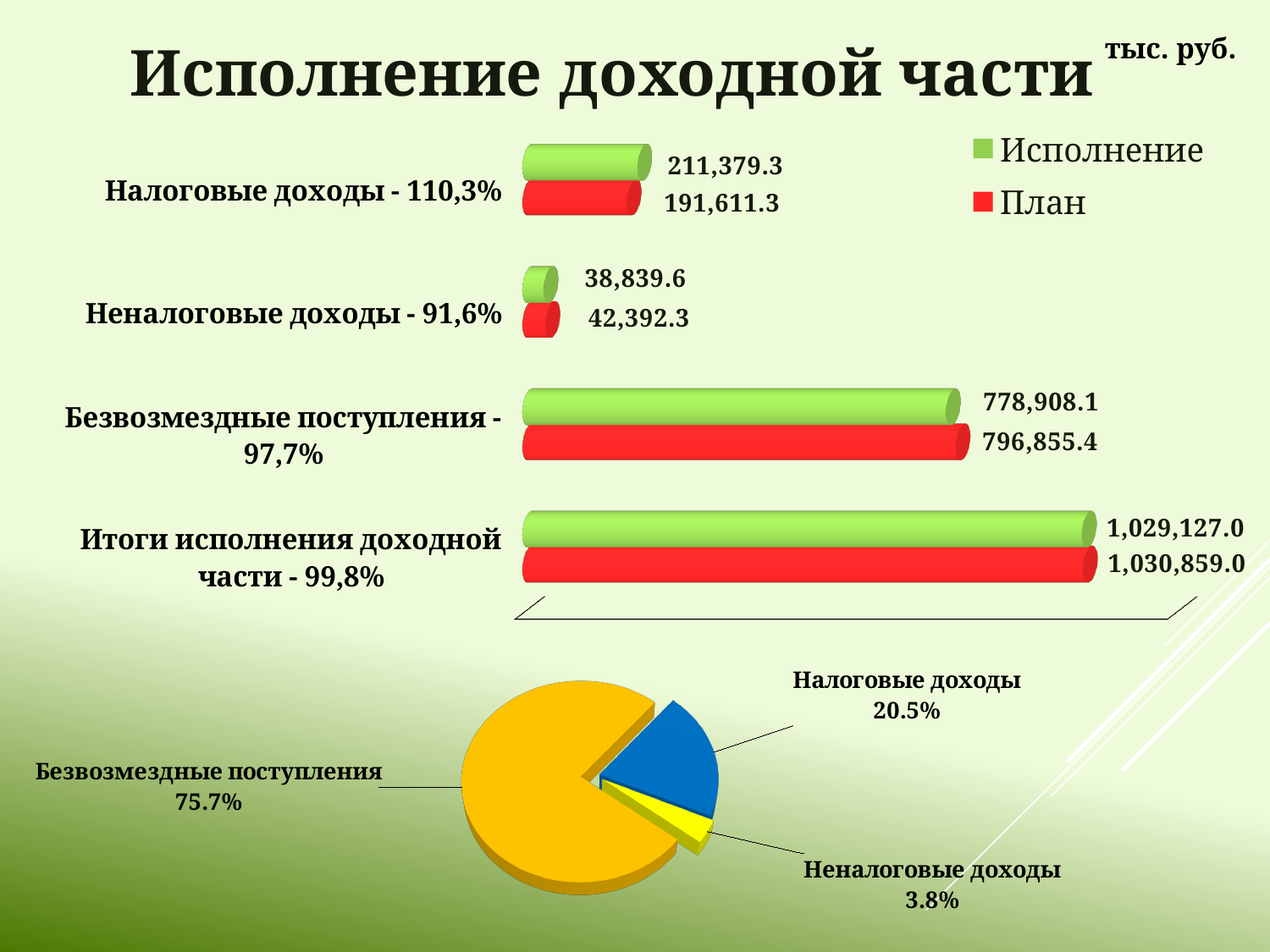
In the bar chart, which is larger for Безвозмездные поступления: Исполнение or План? План In the pie chart, which slice is the smallest? Неналоговые доходы In the bar chart, what is the План value for Безвозмездные поступления? 796,855.4 In the bar chart, which category has the lowest Исполнение value? Неналоговые доходы What type of chart is the top chart on the slide? Bar chart In the pie chart, what share does Безвозмездные поступления have? 75.7% In the bar chart, what is the Исполнение value for Налоговые доходы? 211,379.3 How many series does the legend of the bar chart list? 2 In the bar chart legend, which colour represents План? Red In the bar chart, what is the difference between the Исполнение and План values for Налоговые доходы? 19,768.0 In the bar chart, what is the Исполнение value for Итоги исполнения доходной части? 1,029,127.0 In the bar chart, what is the План value for Неналоговые доходы? 42,392.3